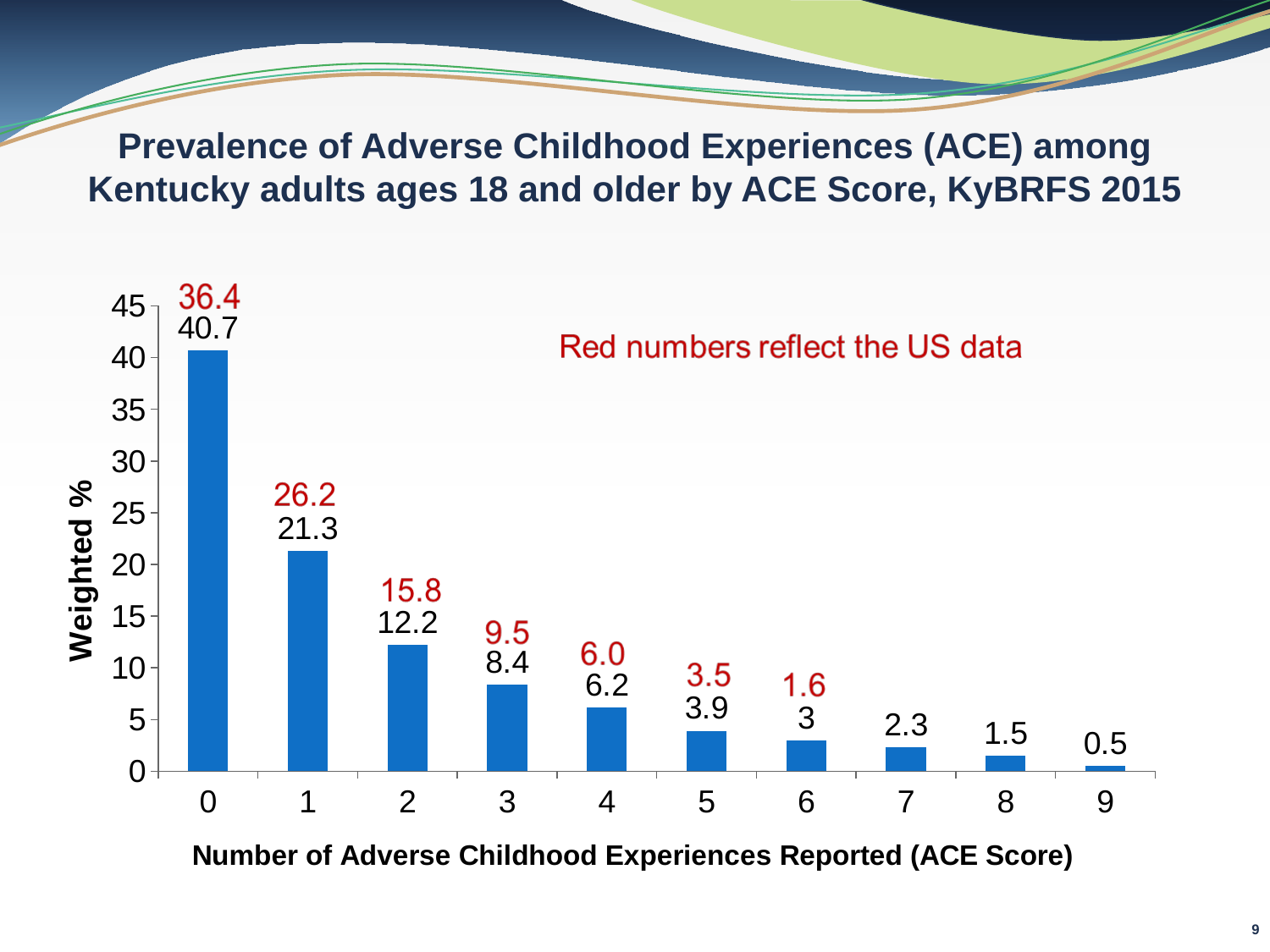
What is the difference between the Kentucky weighted % for ACE score 0 and ACE score 1? 19.4 What type of chart is shown on the slide? Bar chart How many ACE score categories are shown on the x axis? 10 What is the difference between the US value and the Kentucky value for an ACE score of 1? 4.9 Do the Kentucky weighted % values rise or fall as the ACE score increases from 0 to 9? Fall Which ACE score has the lowest weighted % for Kentucky? 9 Which ACE score has the highest weighted % for Kentucky? 0 What is the weighted % for Kentucky adults with an ACE score of 9? 0.5 What is the US value (red number) shown for an ACE score of 2? 15.8 Which is larger for an ACE score of 4: the Kentucky value or the US value? Kentucky value (6.2) What is the weighted % for Kentucky adults with an ACE score of 0? 40.7 What is the weighted % for Kentucky adults with an ACE score of 3? 8.4